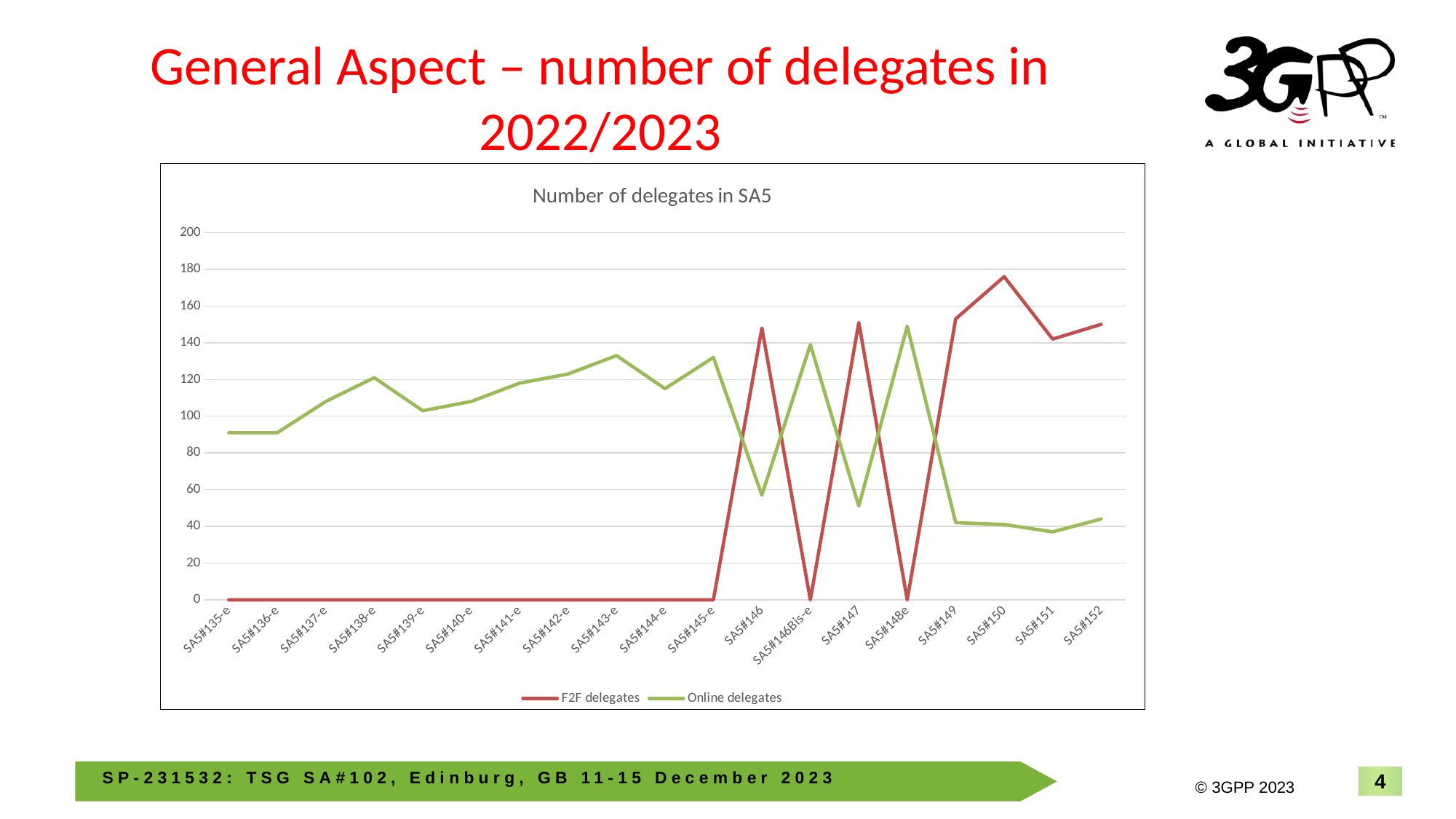
Is the value for F2F delegates at SA5#150 greater or less than 160? greater What is the title of the chart? Number of delegates in SA5 At which meeting is the number of F2F delegates highest? SA5#150 Do the Online delegates values rise or fall from SA5#135-e to SA5#138-e? rise Is the value for Online delegates at SA5#149 greater or less than 60? less What is the value for F2F delegates at SA5#135-e? 0 How many meetings are shown along the x axis? 19 Is the value for Online delegates at SA5#138-e greater or less than 100? greater How many series does the legend list? 2 At which meeting is the number of Online delegates highest? SA5#148e At SA5#147, which series has the larger value, F2F delegates or Online delegates? F2F delegates What kind of chart is shown on the slide? line chart